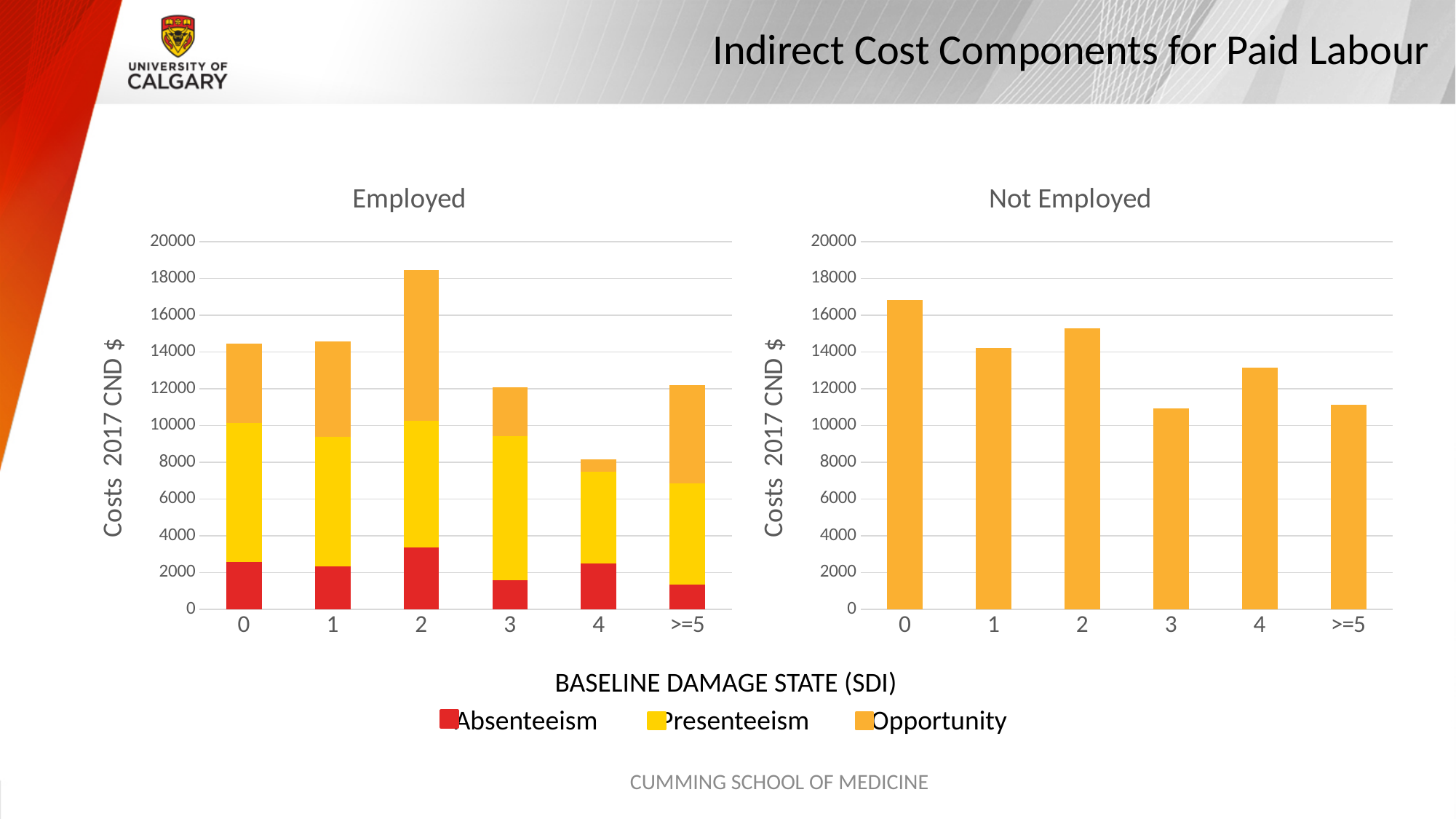
How many baseline damage state categories are shown on the x axis of the Employed chart? 6 What is the y-axis label of the Not Employed chart? Costs 2017 CND $ In the Not Employed chart, is the cost for damage state 3 greater or less than 12000? less In the Employed chart, is the total cost for damage state 4 greater or less than 10000? less In the Employed chart, which baseline damage state has the lowest total cost? 4 In the Employed chart, is the total cost for damage state 2 greater or less than 18000? greater How many series does the legend list? 3 What kind of chart is the Employed chart? bar chart In the Not Employed chart, which baseline damage state has the highest cost? 0 In the Employed chart, which baseline damage state has the highest total cost? 2 In the Not Employed chart, which is larger, the cost for damage state 2 or damage state 4? damage state 2